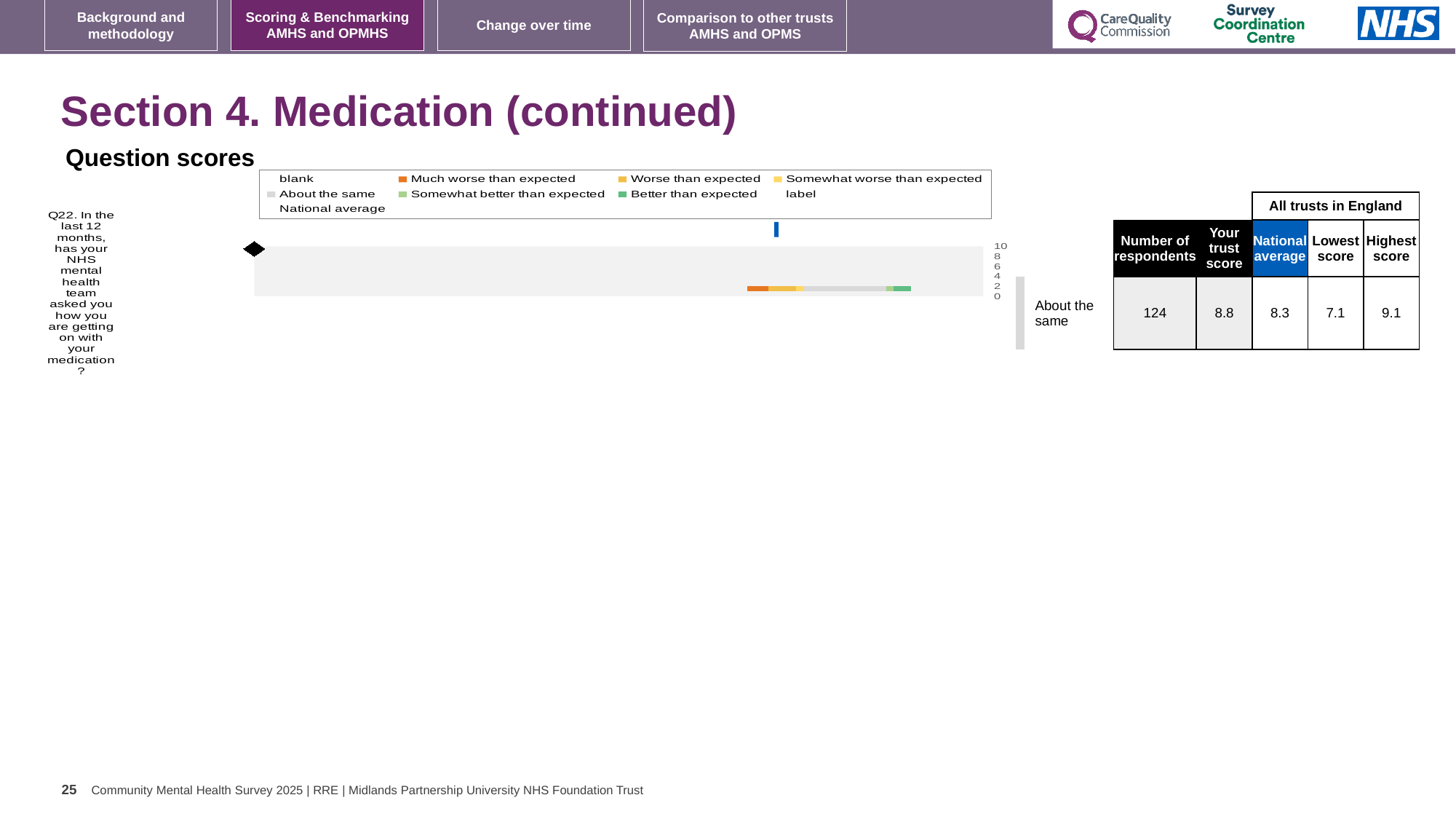
Which question is plotted in the Question scores chart? Q22. In the last 12 months, has your NHS mental health team asked you how you are getting on with your medication? Which legend entry in the Question scores chart is shown in orange? Much worse than expected What is the trust score for Q22 shown next to the chart? 8.8 What is the number of respondents for Q22? 124 What benchmark category is given for Q22? About the same What is the difference between the highest score and the lowest score for Q22? 2.0 What kind of chart is shown under 'Question scores'? bar chart What is the highest tick value shown on the axis of the Question scores chart? 10 How many questions (categories) are plotted in the Question scores chart? 1 Is the trust score for Q22 higher or lower than the national average? higher How many entries does the legend of the Question scores chart list? 9 What is the national average for Q22 shown next to the chart? 8.3